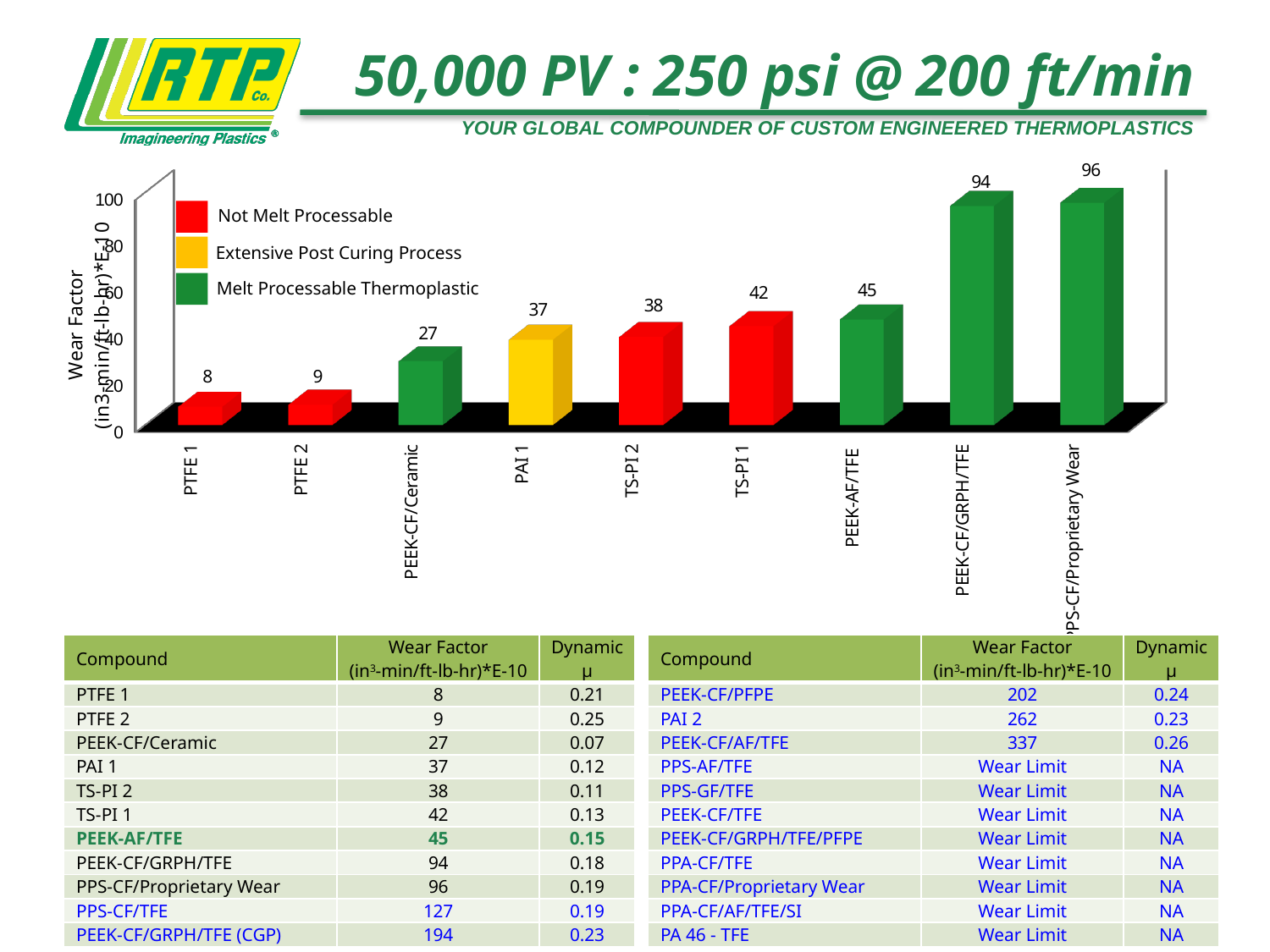
How many entries does the chart legend list? 3 Which compound has the lowest wear factor in the chart? PTFE 1 What type of chart is shown on the slide? bar chart Which has a larger wear factor in the chart, PEEK-CF/Ceramic or TS-PI 2? TS-PI 2 How many compounds are plotted as bars in the chart? 9 Is the wear factor for PEEK-AF/TFE greater or less than 40? greater What is the wear factor value shown for PEEK-CF/GRPH/TFE in the chart? 94 What is the wear factor value shown for PEEK-CF/Ceramic in the chart? 27 According to the chart legend, what does a green bar represent? Melt Processable Thermoplastic Which compound has the highest wear factor in the chart? PPS-CF/Proprietary Wear What is the wear factor value shown for TS-PI 1 in the chart? 42 What is the difference between the wear factor of PEEK-AF/TFE and that of PAI 1 in the chart? 8